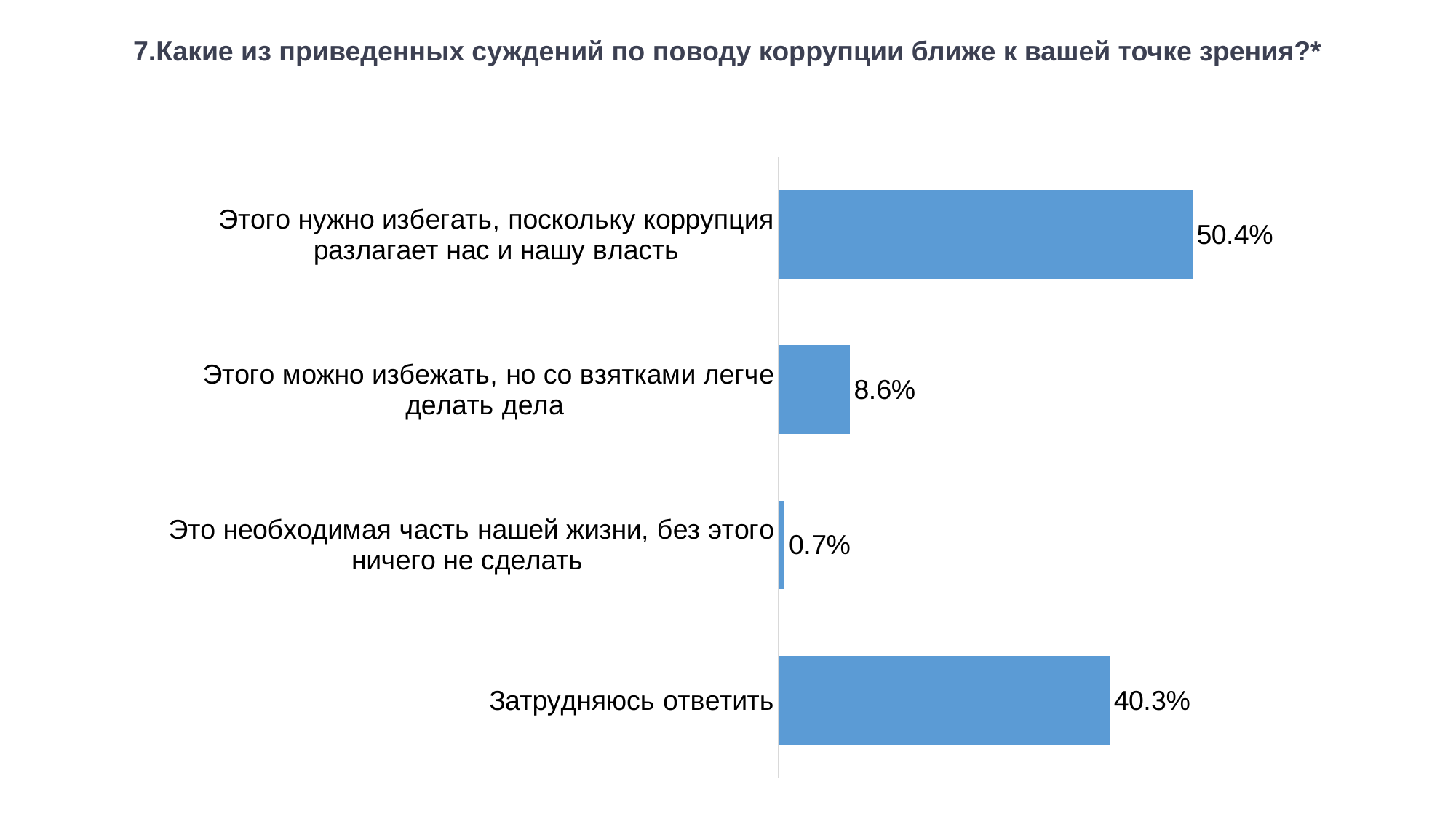
What is the difference between the values for "Этого можно избежать, но со взятками легче делать дела" and "Это необходимая часть нашей жизни, без этого ничего не сделать"? 7.9% What is the value for "Этого можно избежать, но со взятками легче делать дела"? 8.6% Which category has the highest value? Этого нужно избегать, поскольку коррупция разлагает нас и нашу власть What is the difference between the values for "Этого нужно избегать, поскольку коррупция разлагает нас и нашу власть" and "Затрудняюсь ответить"? 10.1% What is the value for "Этого нужно избегать, поскольку коррупция разлагает нас и нашу власть"? 50.4% Which category has the lowest value? Это необходимая часть нашей жизни, без этого ничего не сделать What kind of chart is shown on the slide? Bar chart What is the value for "Это необходимая часть нашей жизни, без этого ничего не сделать"? 0.7% What is the value for "Затрудняюсь ответить"? 40.3% Which is larger: the value for "Затрудняюсь ответить" or the value for "Этого можно избежать, но со взятками легче делать дела"? Затрудняюсь ответить What is the title of the chart? 7.Какие из приведенных суждений по поводу коррупции ближе к вашей точке зрения?* How many categories are shown in the chart? 4